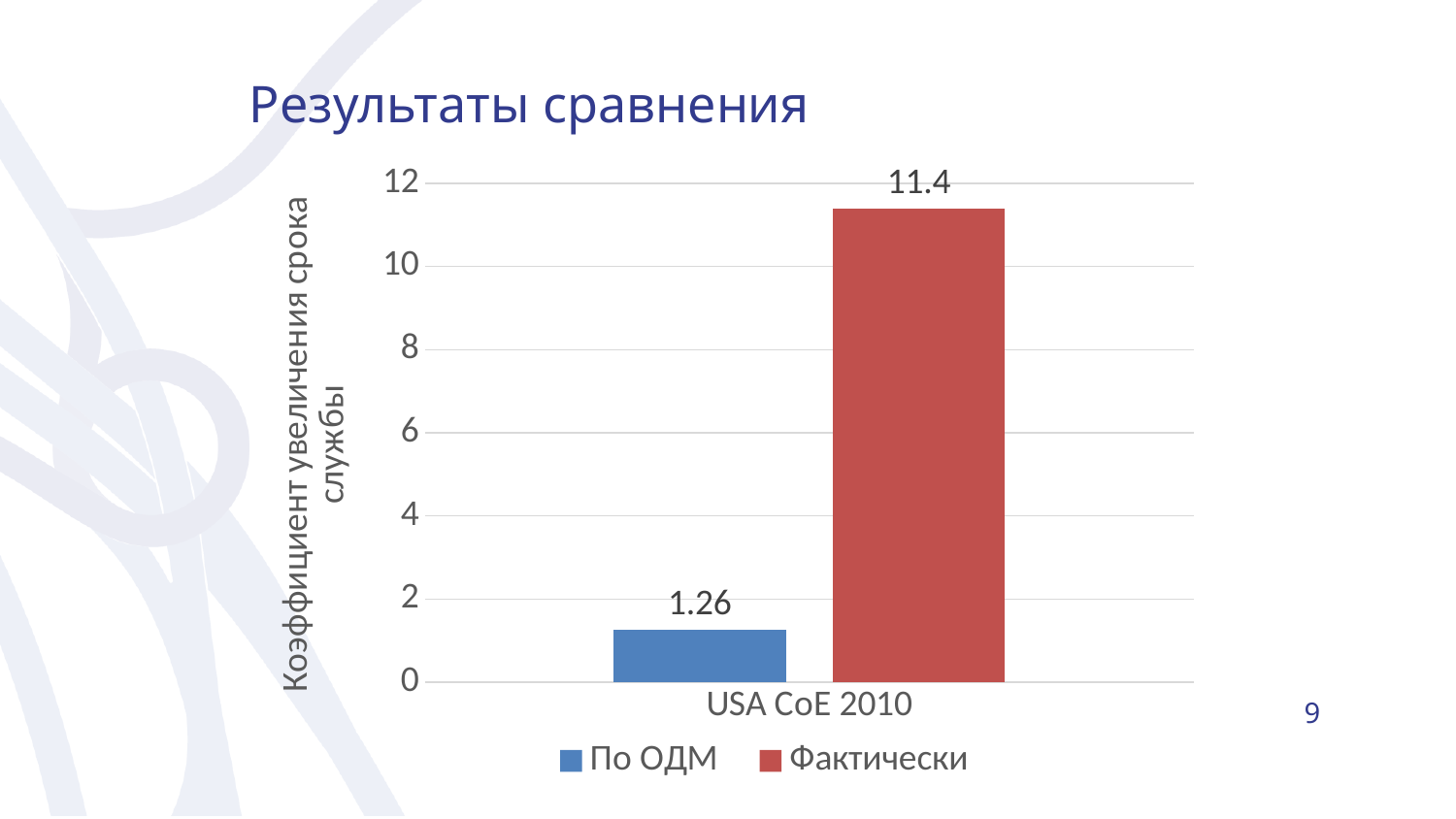
How many series does the legend list? 2 What is the category label on the x axis? USA CoE 2010 What is the difference between the "Фактически" and "По ОДМ" values for USA CoE 2010? 10.14 What is the value of the "По ОДМ" series for USA CoE 2010? 1.26 Is the value for "Фактически" greater or less than 10? greater What kind of chart is shown on the slide? Bar chart Is the value for "По ОДМ" greater or less than 2? less What is the y-axis title of the chart? Коэффициент увеличения срока службы Which series has the higher value for USA CoE 2010, "По ОДМ" or "Фактически"? Фактически How many categories are shown on the x axis? 1 What is the value of the "Фактически" series for USA CoE 2010? 11.4